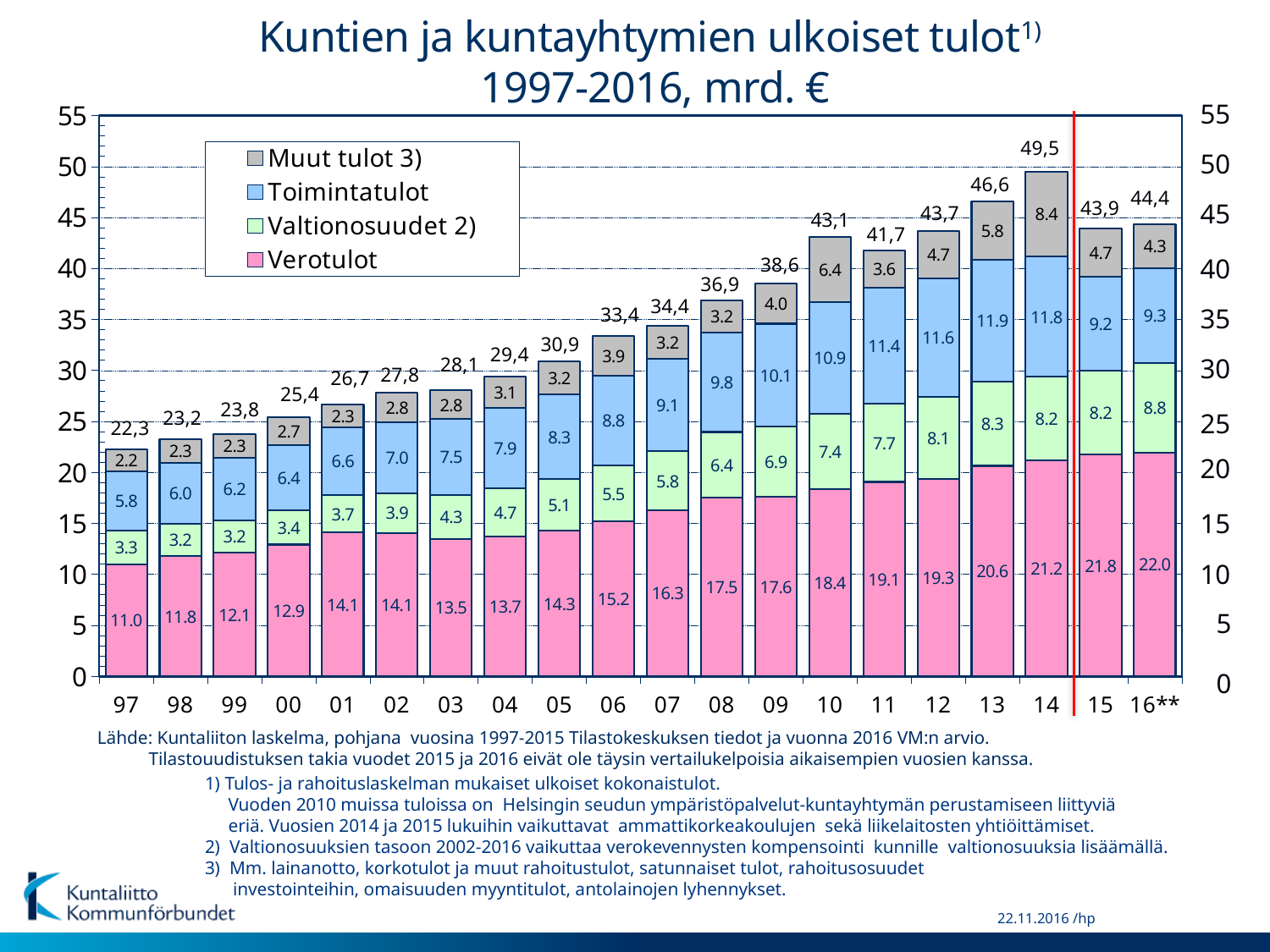
Which is larger, the Toimintatulot value for 2014 or for 2015? 2014 What kind of chart is shown on the slide? Stacked bar chart By how much did Verotulot increase from 1997 to 2016? 11.0 Which year has the highest total external income? 14 What is the Verotulot value for 2016 (16**)? 22.0 What is the Toimintatulot value for 2013? 11.9 How many series does the legend list? 4 What is the Muut tulot 3) value for 2014? 8.4 What is the Valtionosuudet 2) value for 2005? 5.1 Which year has the lowest total external income? 97 How many years are shown on the x axis? 20 What is the total of the stacked bar for 2010? 43,1